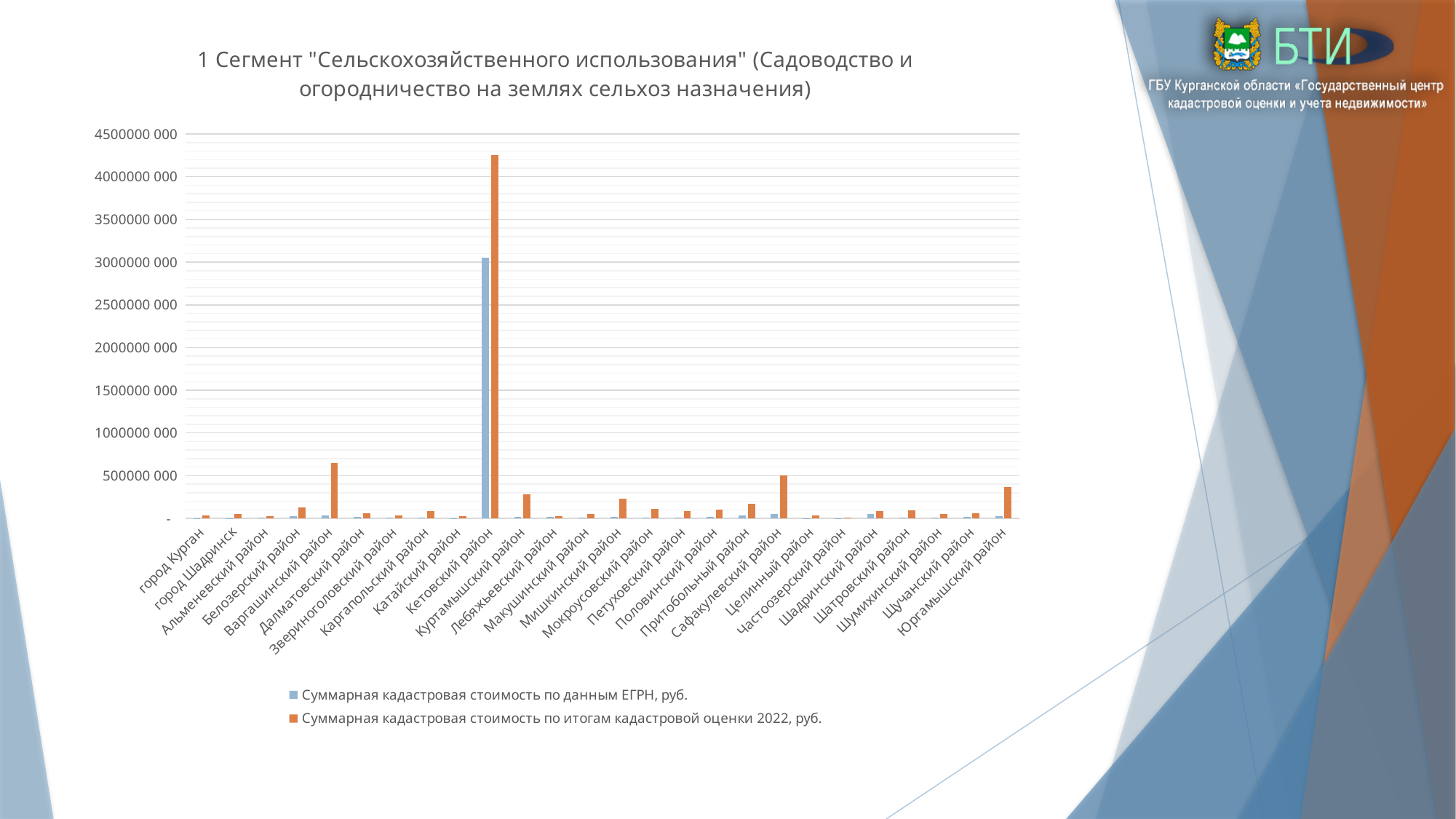
Which category has the highest value for "Суммарная кадастровая стоимость по итогам кадастровой оценки 2022, руб."? Кетовский район Is the value for Кетовский район in the series "Суммарная кадастровая стоимость по итогам кадастровой оценки 2022, руб." greater or less than 4000000 000? greater Is the value for Юргамышский район in the series "Суммарная кадастровая стоимость по итогам кадастровой оценки 2022, руб." greater or less than 500000 000? less Is the value for Кетовский район in the series "Суммарная кадастровая стоимость по данным ЕГРН, руб." greater or less than 2500000 000? greater In the series "Суммарная кадастровая стоимость по итогам кадастровой оценки 2022, руб.", which is larger: Варгашинский район or Юргамышский район? Варгашинский район What kind of chart is shown on the slide? bar chart How many series does the legend list? 2 Which colour represents the series "Суммарная кадастровая стоимость по итогам кадастровой оценки 2022, руб."? orange How many categories (districts and cities) are shown on the x axis? 26 Which category has the highest value for "Суммарная кадастровая стоимость по данным ЕГРН, руб."? Кетовский район For Кетовский район, which series has the larger value: "по данным ЕГРН" or "по итогам кадастровой оценки 2022"? по итогам кадастровой оценки 2022